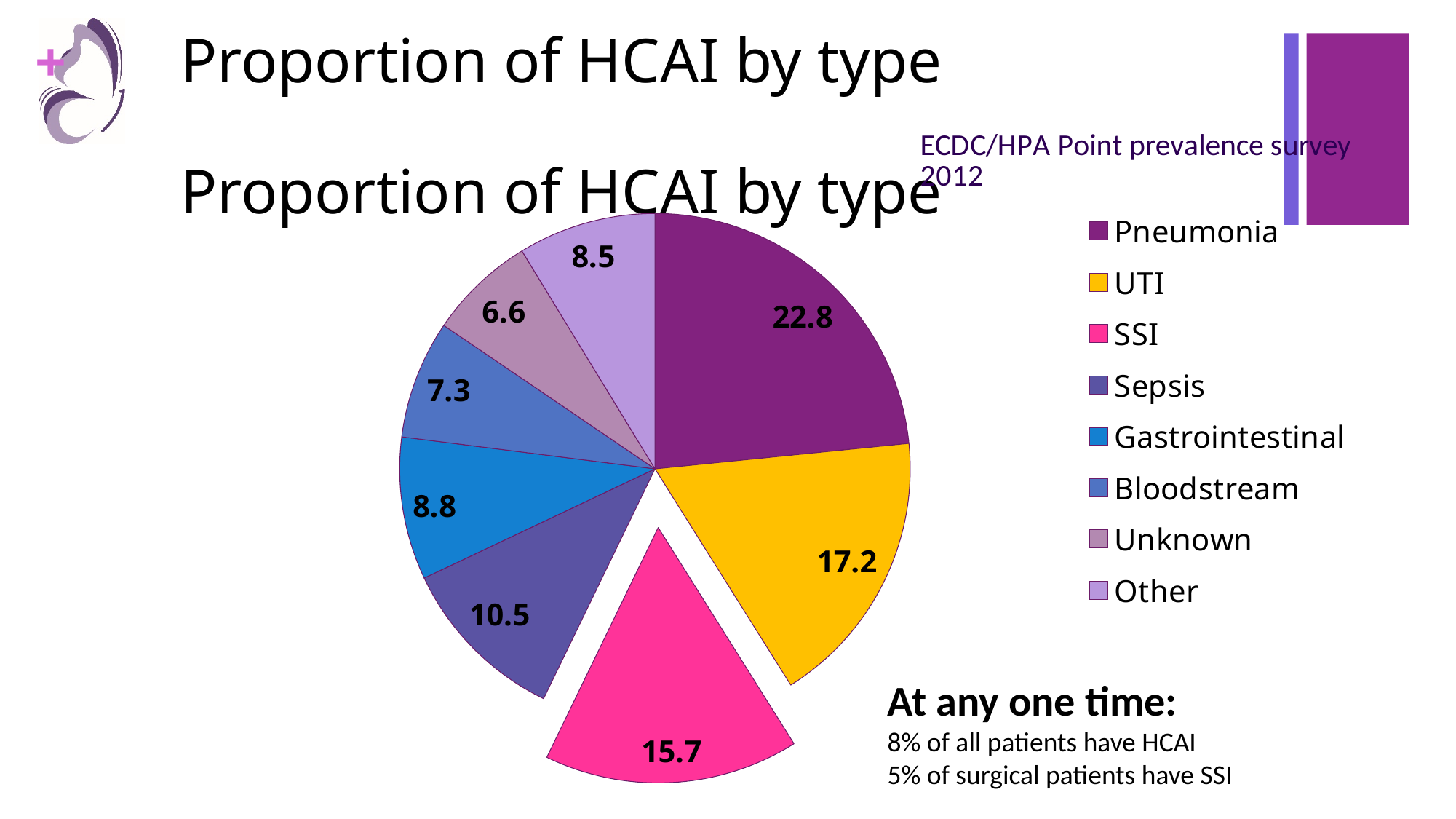
What is the value for Unknown in the pie chart? 6.6 What is the value for Gastrointestinal in the pie chart? 8.8 What kind of chart is shown on the slide? Pie chart Which slice is pulled out (exploded) from the pie chart? SSI How many categories does the pie chart show? 8 Which is larger, the value for Other or the value for Bloodstream? Other Which HCAI type has the smallest slice in the pie chart? Unknown Which HCAI type has the largest slice in the pie chart? Pneumonia What is the value for Pneumonia in the pie chart? 22.8 What is the value for SSI in the pie chart? 15.7 What is the difference between the values for Pneumonia and UTI? 5.6 What is the difference between the values for Sepsis and Bloodstream? 3.2